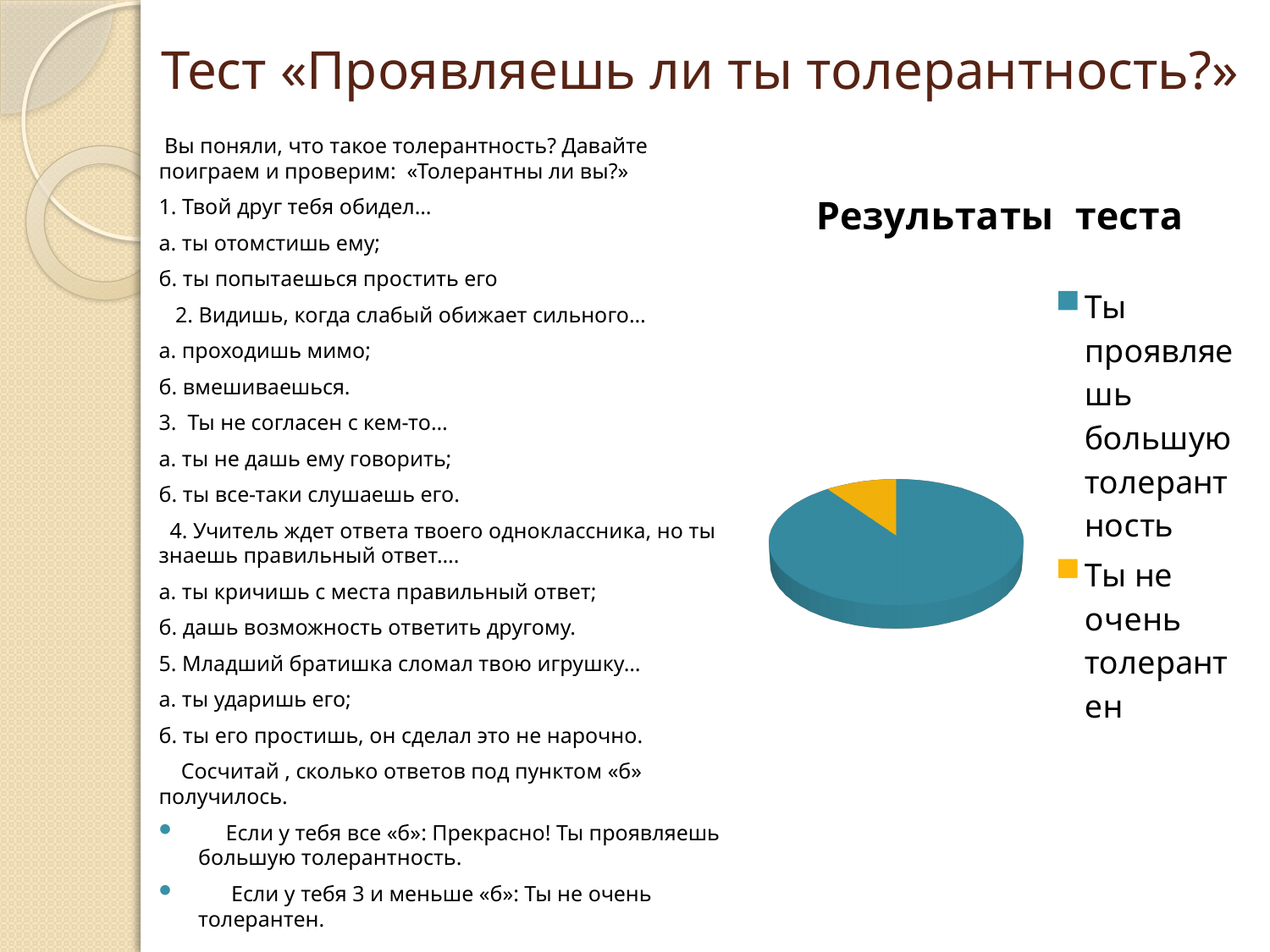
How many slices does the pie chart have? 2 How many entries does the chart legend list? 2 Which slice is larger: "Ты проявляешь большую толерантность" or "Ты не очень толерантен"? Ты проявляешь большую толерантность What colour is the slice for "Ты не очень толерантен"? orange What kind of chart is shown on the slide? pie chart Which category has the largest slice of the pie? Ты проявляешь большую толерантность What is the title of the chart? Результаты теста Which category has the smallest slice of the pie? Ты не очень толерантен